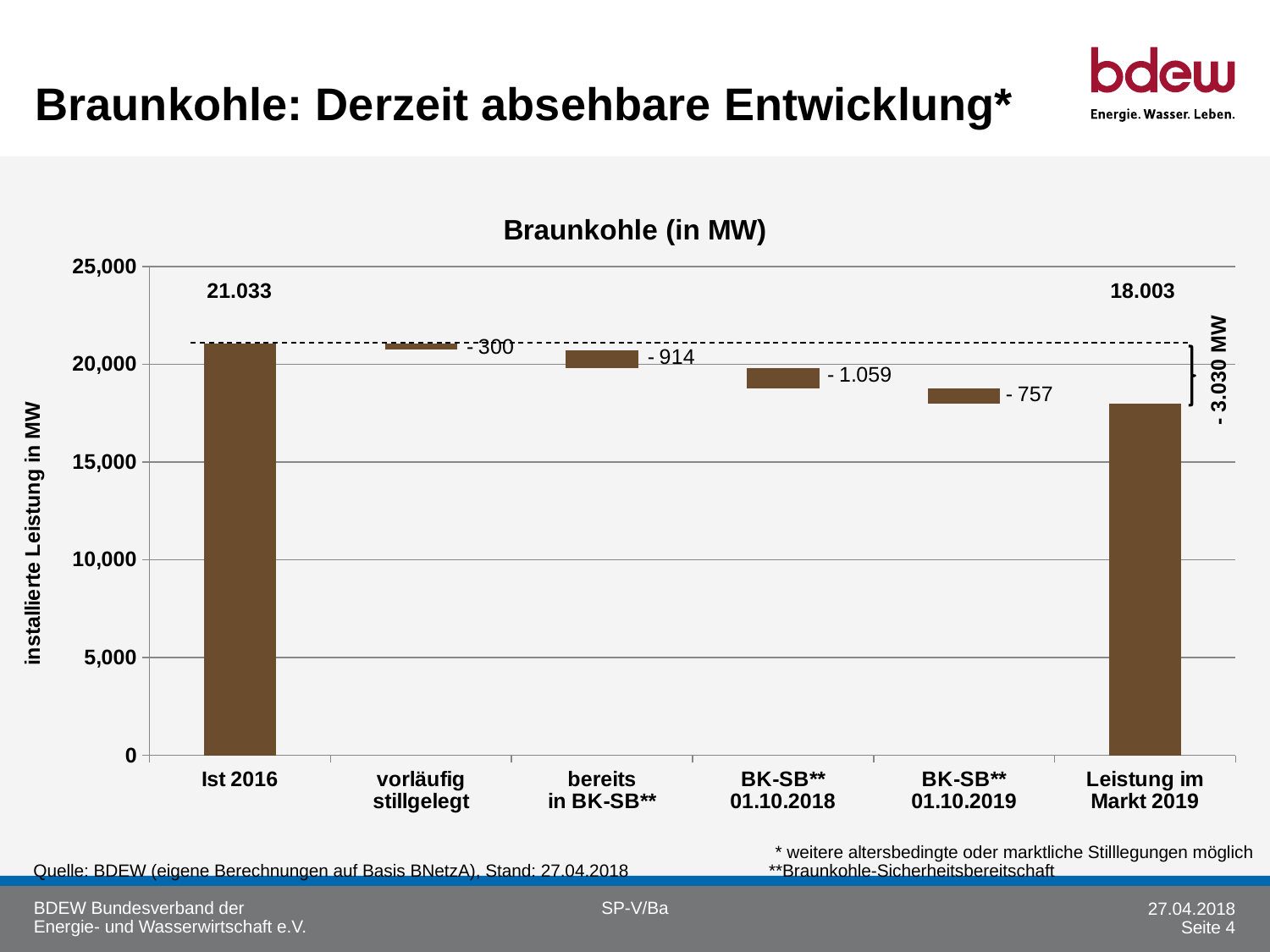
What reduction is labelled for "bereits in BK-SB**"? - 914 Which of the four reduction steps is the smallest? vorläufig stillgelegt Is the value for "Leistung im Markt 2019" greater or less than 20,000? less What reduction is labelled for "vorläufig stillgelegt"? - 300 What is the value shown for "Ist 2016" in the Braunkohle (in MW) chart? 21.033 What reduction is labelled for "BK-SB** 01.10.2018"? - 1.059 How many categories are shown on the x axis of the chart? 6 What reduction is labelled for "BK-SB** 01.10.2019"? - 757 What is the total reduction from Ist 2016 to Leistung im Markt 2019, as labelled by the bracket on the right? - 3.030 MW What is the value shown for "Leistung im Markt 2019"? 18.003 What is the label of the vertical axis? installierte Leistung in MW Which of the four reduction steps is the largest? BK-SB** 01.10.2018